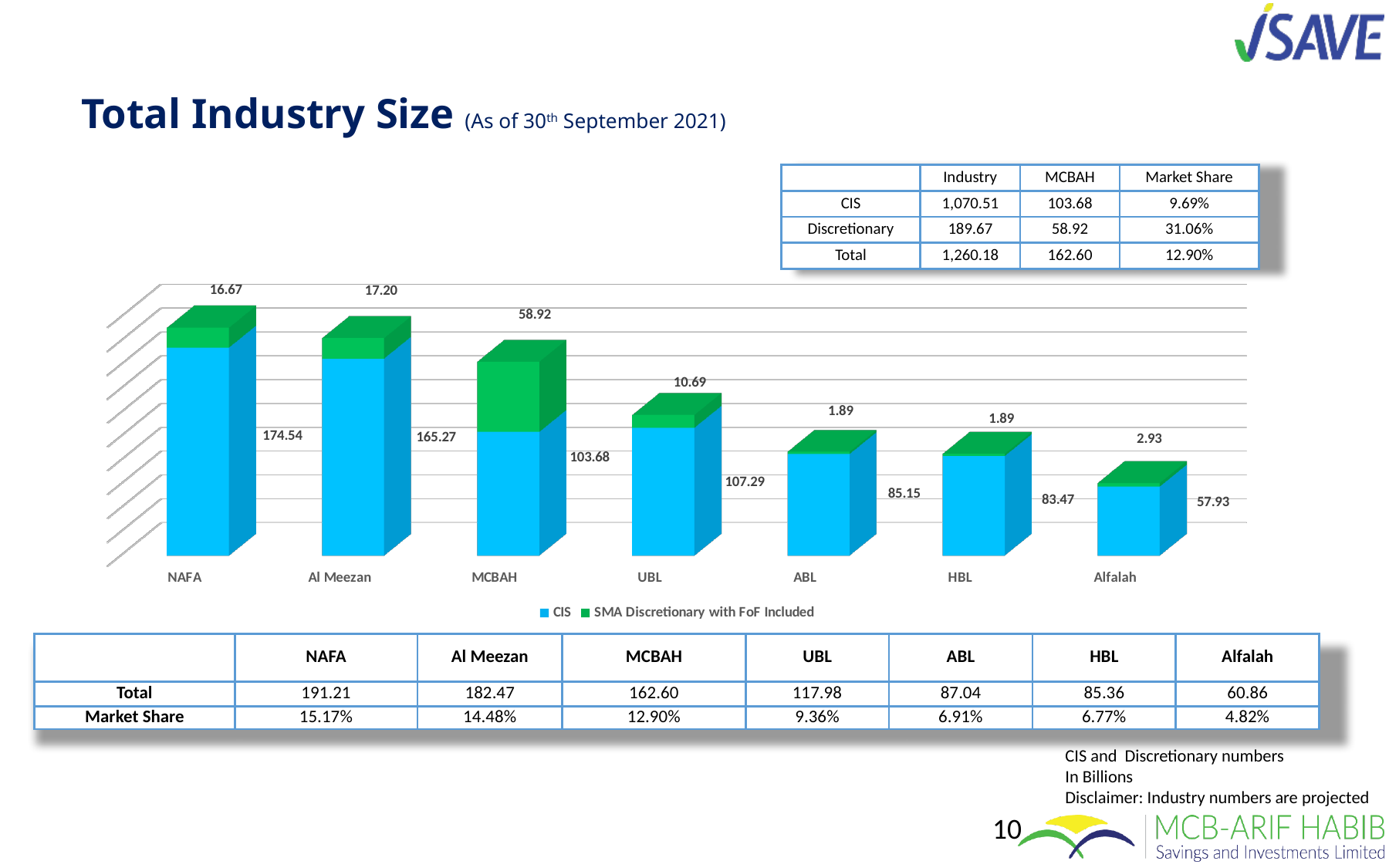
Which category has the lowest CIS value? Alfalah What is the CIS value for NAFA? 174.54 What is the difference between the CIS values of NAFA and Al Meezan? 9.27 What is the total of the stacked bar for UBL? 117.98 Which has a larger CIS value, MCBAH or UBL? UBL How many series does the chart legend list? 2 How many categories are shown on the x axis of the chart? 7 Which category has the highest SMA Discretionary with FoF Included value? MCBAH What is the SMA Discretionary with FoF Included value for MCBAH? 58.92 What is the CIS value for Alfalah? 57.93 What kind of chart is shown on the slide? Stacked bar chart Which series is shown in green in the chart? SMA Discretionary with FoF Included